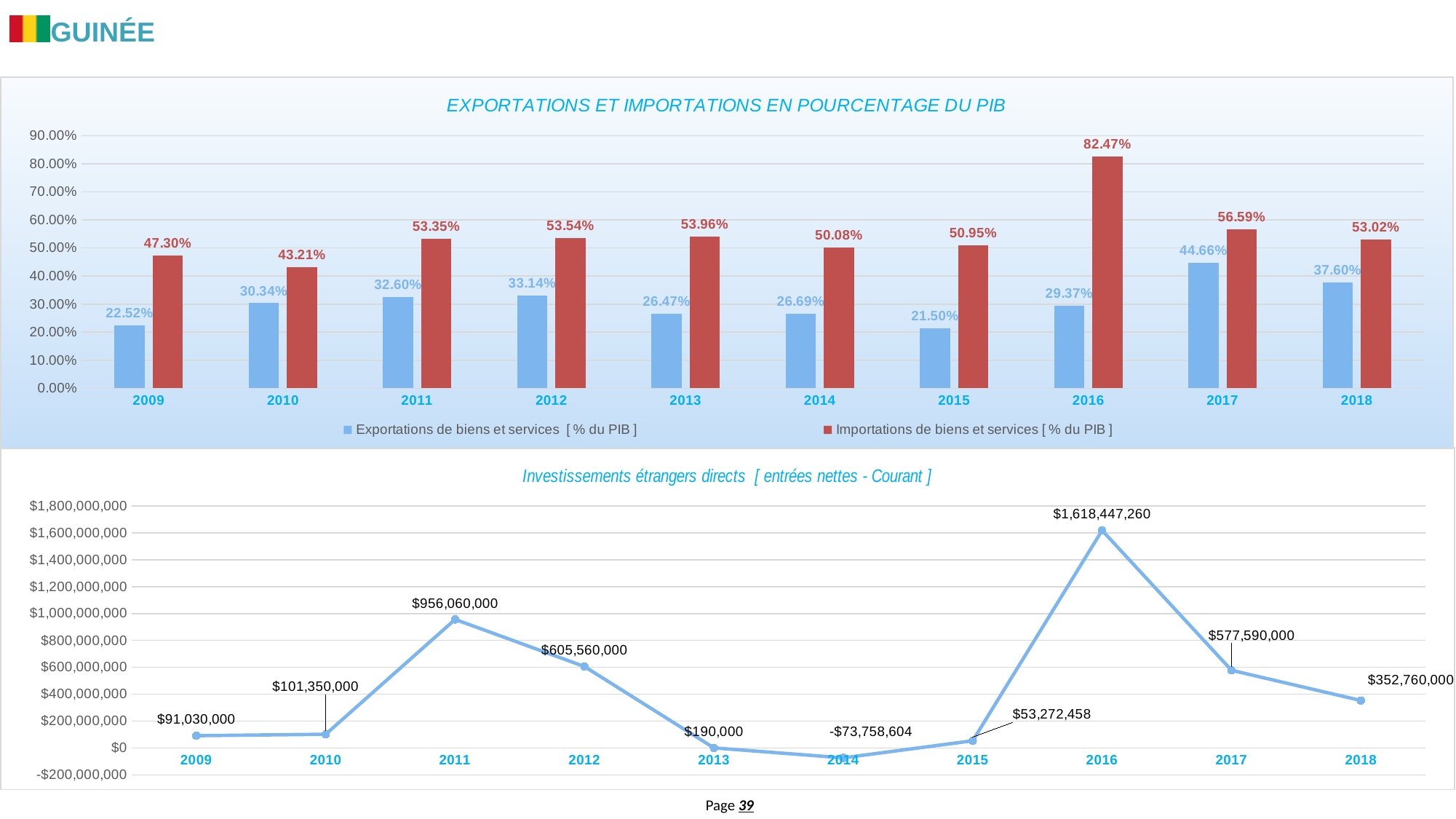
In the chart 'Investissements étrangers directs', which year has the highest value? 2016 In the chart 'Investissements étrangers directs', which year has the lowest value? 2014 In the chart 'Exportations et importations en pourcentage du PIB', what is the difference between Importations and Exportations in 2016? 53.10% In the chart 'Investissements étrangers directs', how many years are plotted on the x axis? 10 In the chart 'Investissements étrangers directs', what is the difference between the 2017 and 2018 values? $224,830,000 In the chart 'Exportations et importations en pourcentage du PIB', which is larger in 2010: Exportations or Importations? Importations In the chart 'Investissements étrangers directs', what is the value for 2011? $956,060,000 In the chart 'Exportations et importations en pourcentage du PIB', what is the value of Exportations de biens et services for 2017? 44.66% What kind of chart is 'Investissements étrangers directs [ entrées nettes - Courant ]'? line chart In the chart 'Exportations et importations en pourcentage du PIB', what is the value of Importations de biens et services for 2016? 82.47% In the chart 'Exportations et importations en pourcentage du PIB', how many series does the legend list? 2 In the chart 'Exportations et importations en pourcentage du PIB', which year has the lowest value for Exportations de biens et services? 2015